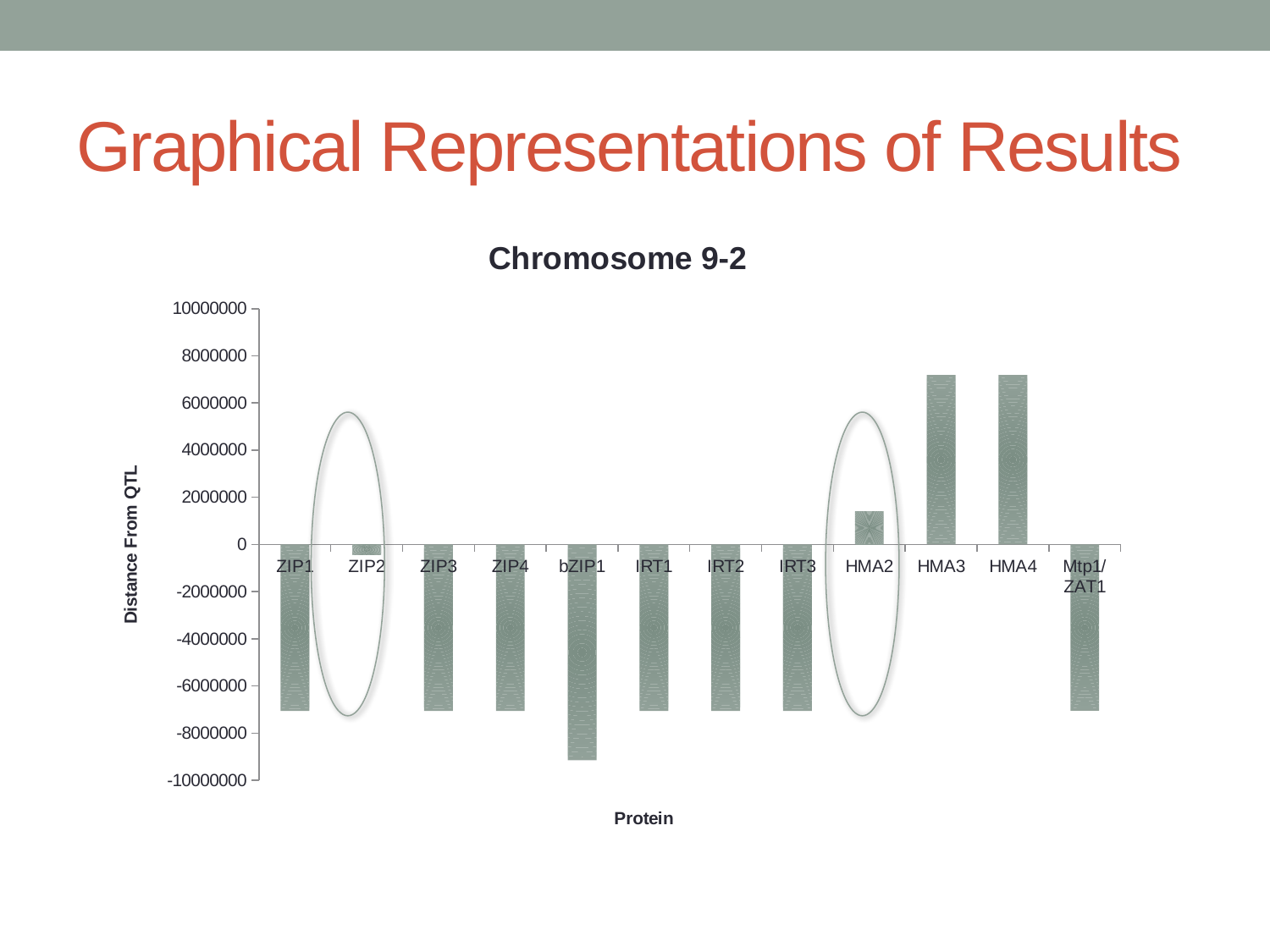
Which has the larger value, HMA2 or HMA3? HMA3 Is the value for bZIP1 greater or less than -8000000? less How many proteins have a positive distance from QTL? 3 Which protein has the lowest (most negative) distance from QTL? bZIP1 Is the value for ZIP2 greater or less than -2000000? greater What type of chart is shown on the slide? Bar chart Is the value for HMA2 greater or less than 2000000? less What is the title of the chart? Chromosome 9-2 What is the label of the y axis? Distance From QTL How many proteins are plotted on the x axis of the chart? 12 Which has the larger value, ZIP2 or bZIP1? ZIP2